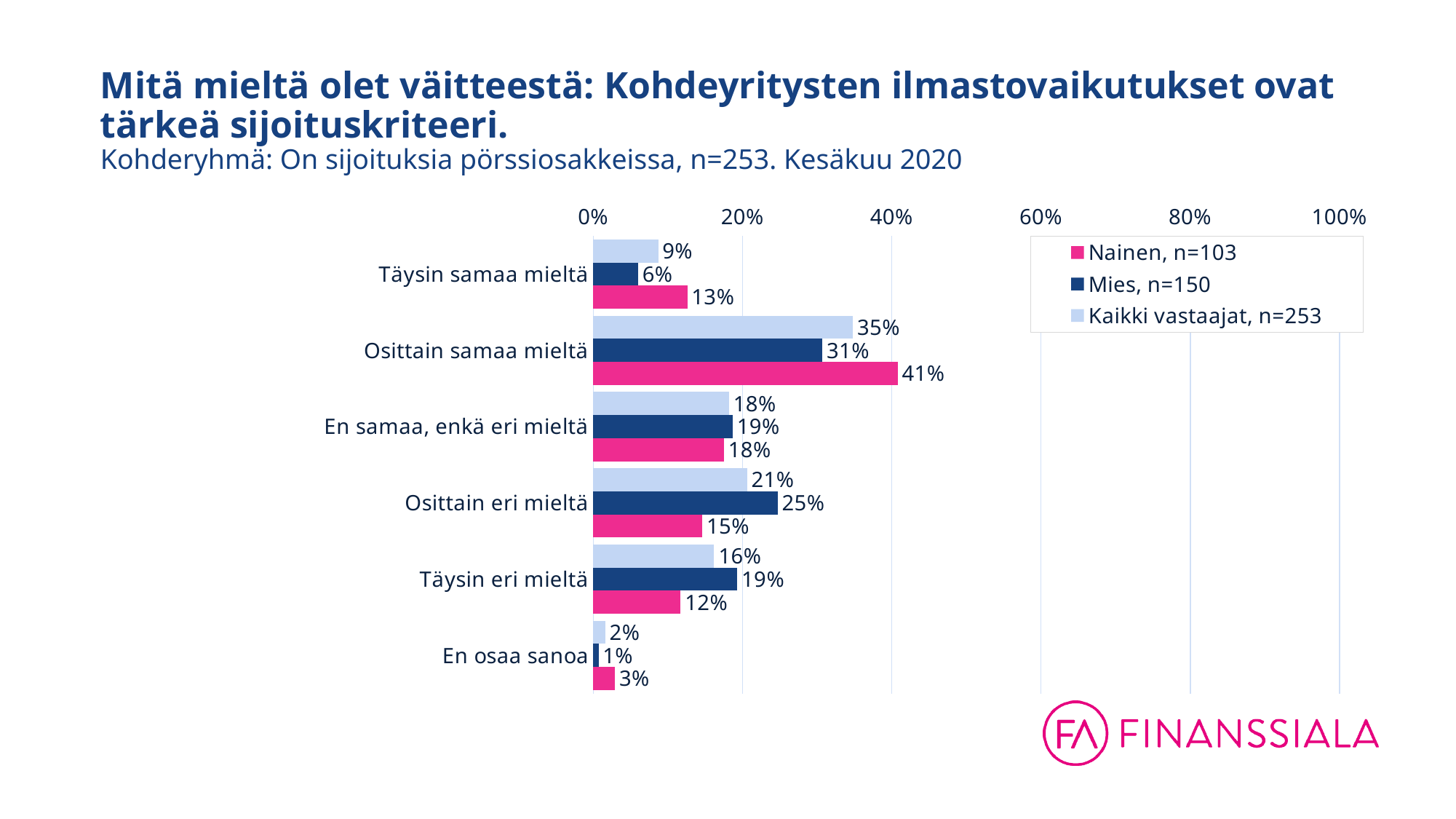
How many response categories are shown on the chart? 6 Which category has the lowest value for "Mies, n=150"? En osaa sanoa What is the difference between the "Nainen, n=103" and "Mies, n=150" values in the "Osittain samaa mieltä" category? 10% In the "Täysin eri mieltä" category, which is larger: the value for "Nainen, n=103" or for "Mies, n=150"? Mies, n=150 Is the value for "Nainen, n=103" in the "Osittain samaa mieltä" category greater or less than 40%? greater How many series does the legend list? 3 Which colour represents the "Nainen, n=103" series? Pink What is the value for "Mies, n=150" in the "Osittain eri mieltä" category? 25% What is the value for "Nainen, n=103" in the "Osittain samaa mieltä" category? 41% What kind of chart is shown on the slide? Bar chart What is the value for "Kaikki vastaajat, n=253" in the "Täysin samaa mieltä" category? 9% Which category has the highest value for "Kaikki vastaajat, n=253"? Osittain samaa mieltä